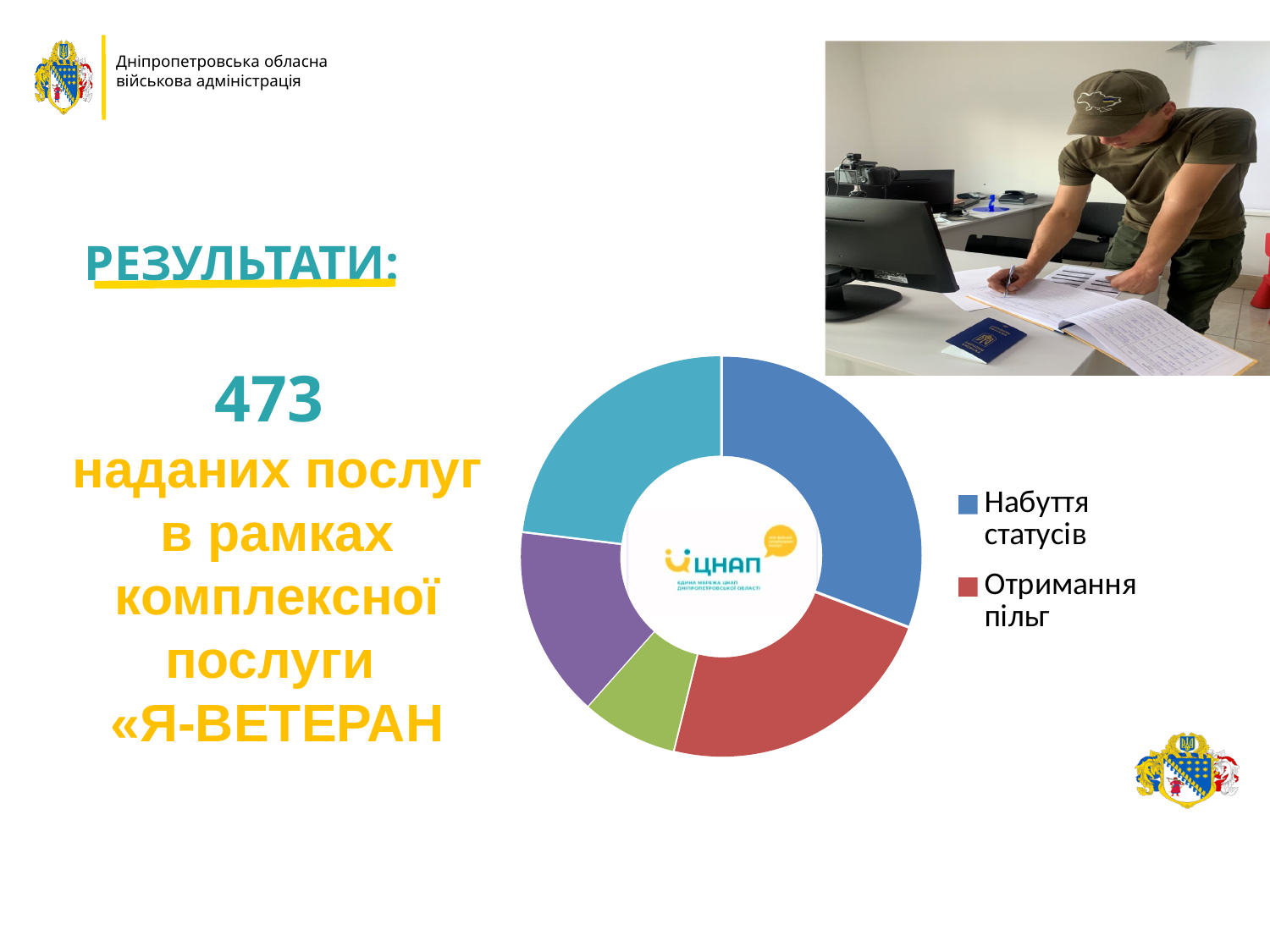
Which is larger in the doughnut chart: the slice for Набуття статусів or the slice for Отримання пільг? Набуття статусів What colour is the slice for Набуття статусів? Blue How many entries does the chart legend list? 2 What colour is the slice for Отримання пільг? Red Which legend category corresponds to the largest slice of the doughnut chart? Набуття статусів What kind of chart is shown on the slide? Doughnut (pie) chart How many slices does the doughnut chart have? 5